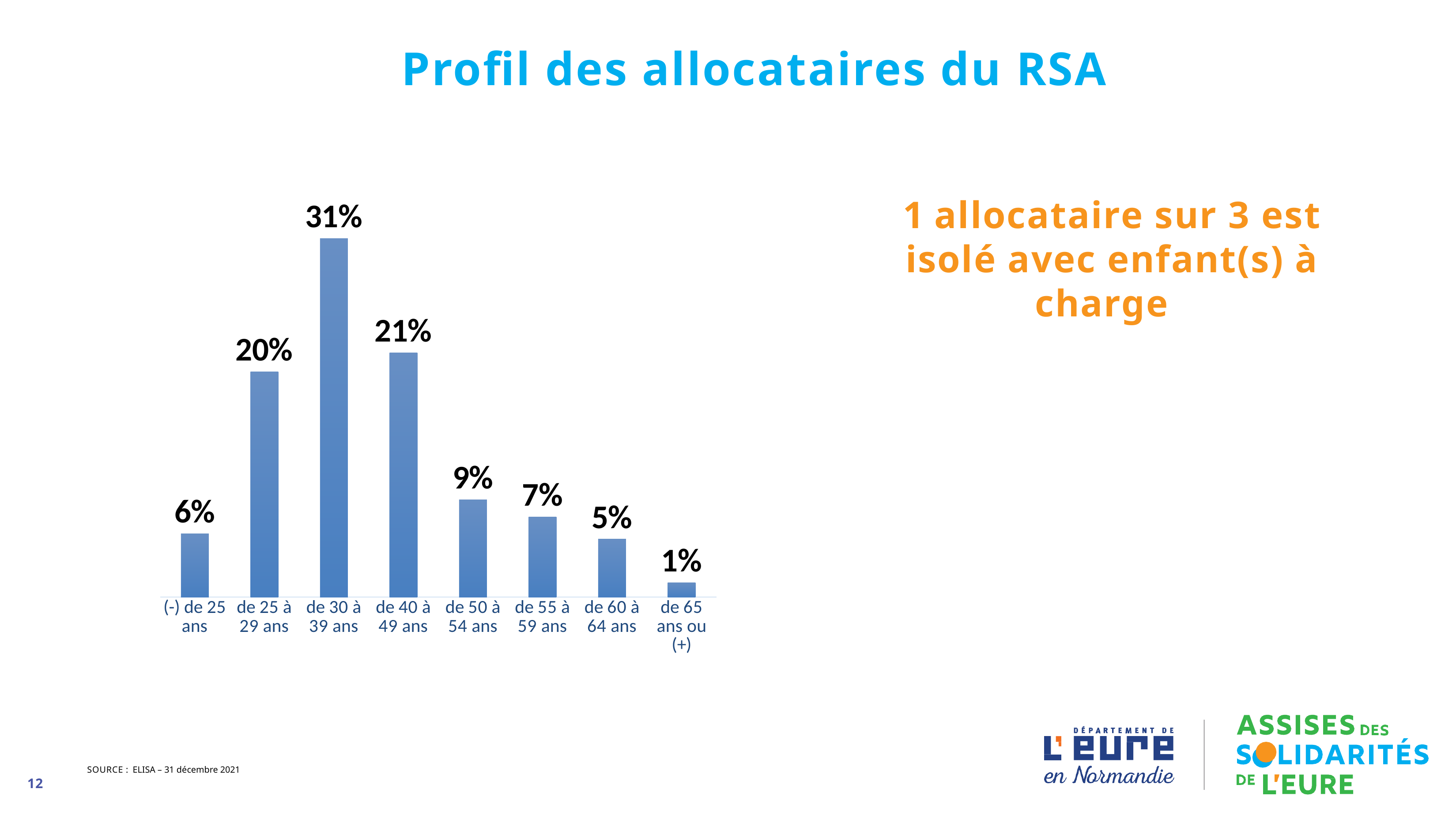
What is the difference between the values for 'de 30 à 39 ans' and 'de 40 à 49 ans'? 10% Which age group has the highest value? de 30 à 39 ans Which age group has the lowest value? de 65 ans ou (+) Do the values rise or fall from 'de 40 à 49 ans' to 'de 65 ans ou (+)'? fall What is the title of the slide containing the chart? Profil des allocataires du RSA What kind of chart is shown on the slide? bar chart What is the difference between the values for 'de 50 à 54 ans' and 'de 55 à 59 ans'? 2% How many age groups are shown in the chart? 8 What is the value for the '(-) de 25 ans' age group? 6% Which is larger, the value for 'de 25 à 29 ans' or the value for 'de 40 à 49 ans'? de 40 à 49 ans What is the value for the 'de 60 à 64 ans' age group? 5% What is the value for the 'de 30 à 39 ans' age group? 31%